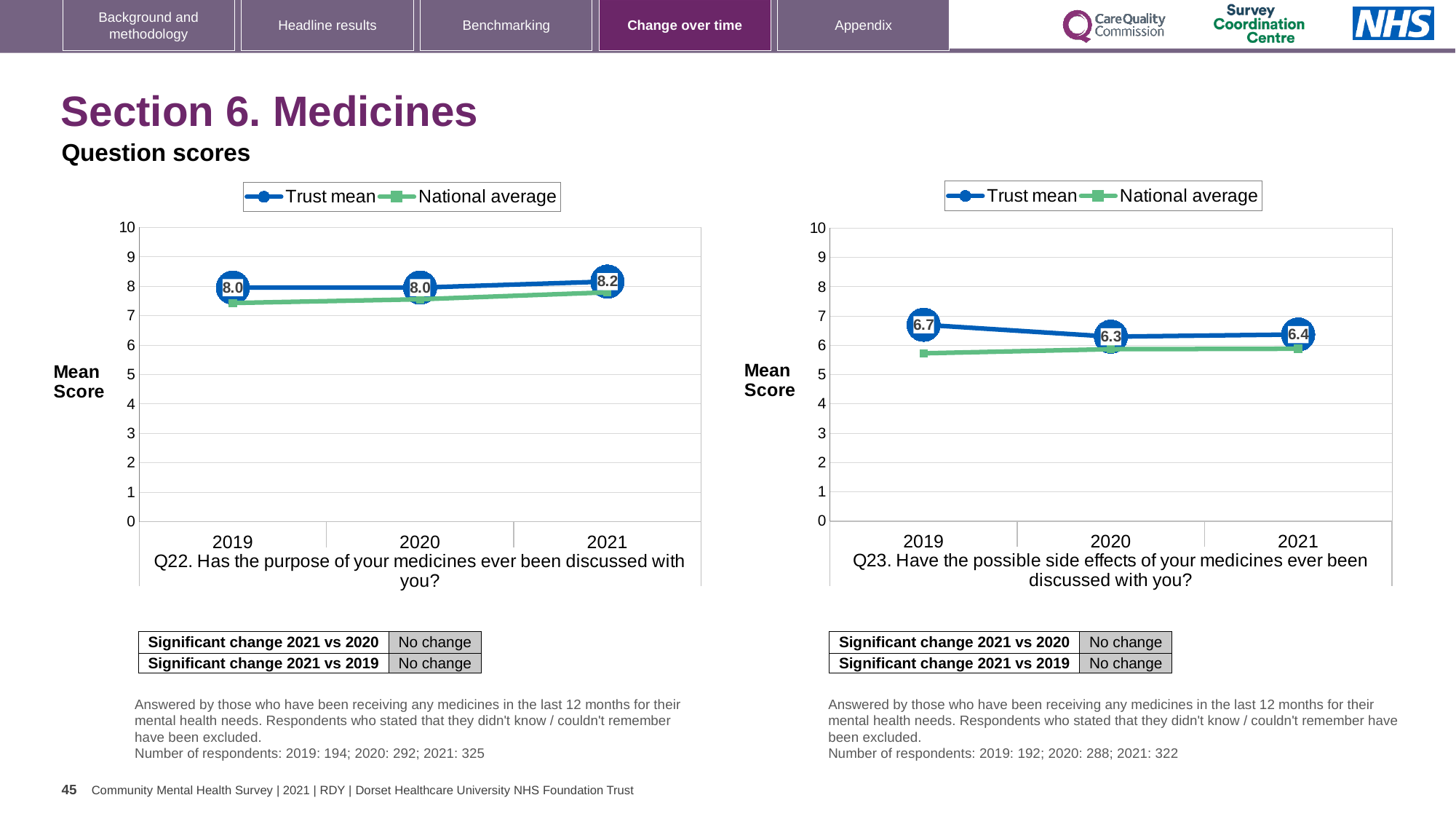
In the Q23 chart (right), what is the difference between the Trust mean scores for 2019 and 2020? 0.4 In the Q23 chart (right), which year has the highest Trust mean score? 2019 In the Q23 chart (right), what is the Trust mean score for 2020? 6.3 In the Q22 chart (left), what is the Trust mean score for 2021? 8.2 In the Q23 chart (right), what is the Trust mean score for 2019? 6.7 In the Q23 chart (right), is the National average for 2019 greater or less than 6? less In the Q22 chart (left), what is the Trust mean score for 2019? 8.0 How many series does the legend of the Q22 chart (left) list? 2 What type of chart is the Q23 chart (right)? Line chart In the Q22 chart (left), is the National average for 2019 greater or less than 8? less In the Q23 chart (right), which year has the lowest Trust mean score? 2020 In the Q22 chart (left), what is the difference between the Trust mean scores for 2021 and 2020? 0.2